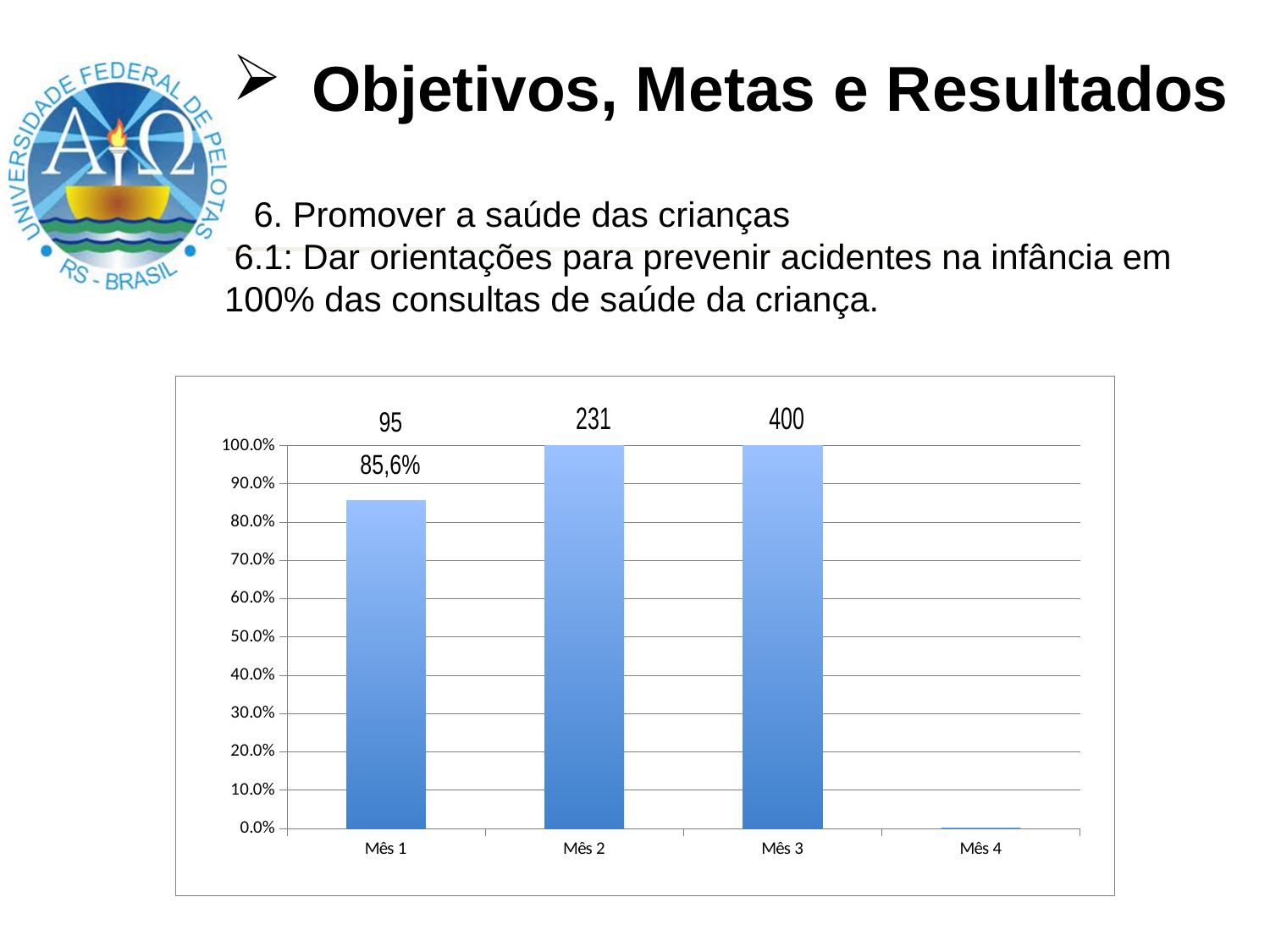
What is the value for Mês 2? 100.0% What number is printed above the bar for Mês 1? 95 Which category has the lowest value? Mês 4 Is the value for Mês 1 greater or less than 80.0%? greater Is the value for Mês 4 greater or less than 10.0%? less What kind of chart is shown on the slide? bar chart What is the value for Mês 3? 100.0% Which is larger, the value for Mês 1 or the value for Mês 2? Mês 2 How many categories are shown on the x axis? 4 What is the value for Mês 1? 85,6% From Mês 1 to Mês 3, do the values rise or fall? rise What number is printed above the bar for Mês 3? 400